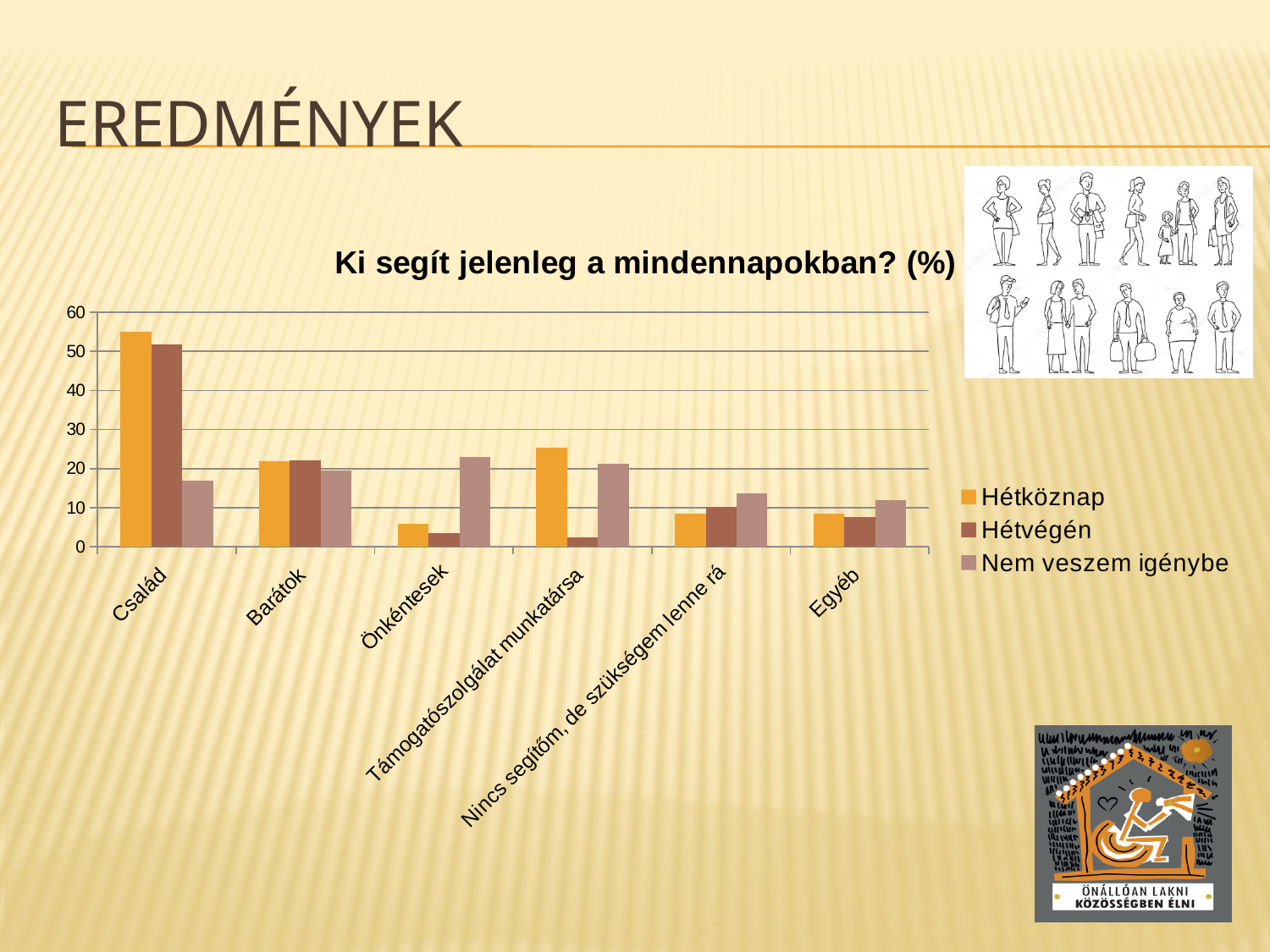
What is the title of the chart? Ki segít jelenleg a mindennapokban? (%) Which category has the highest value for the Hétköznap series? Család For Támogatószolgálat munkatársa, which series has the larger value: Hétköznap or Hétvégén? Hétköznap For Önkéntesek, which series has the larger value: Hétköznap or Nem veszem igénybe? Nem veszem igénybe Is the Nem veszem igénybe value for Család greater or less than 20? less Is the Hétvégén value for Támogatószolgálat munkatársa greater or less than 10? less What kind of chart is shown on the slide? bar chart How many categories are shown on the x axis? 6 Is the Nem veszem igénybe value for Önkéntesek greater or less than 20? greater Which category has the highest value for the Hétvégén series? Család How many series does the legend list? 3